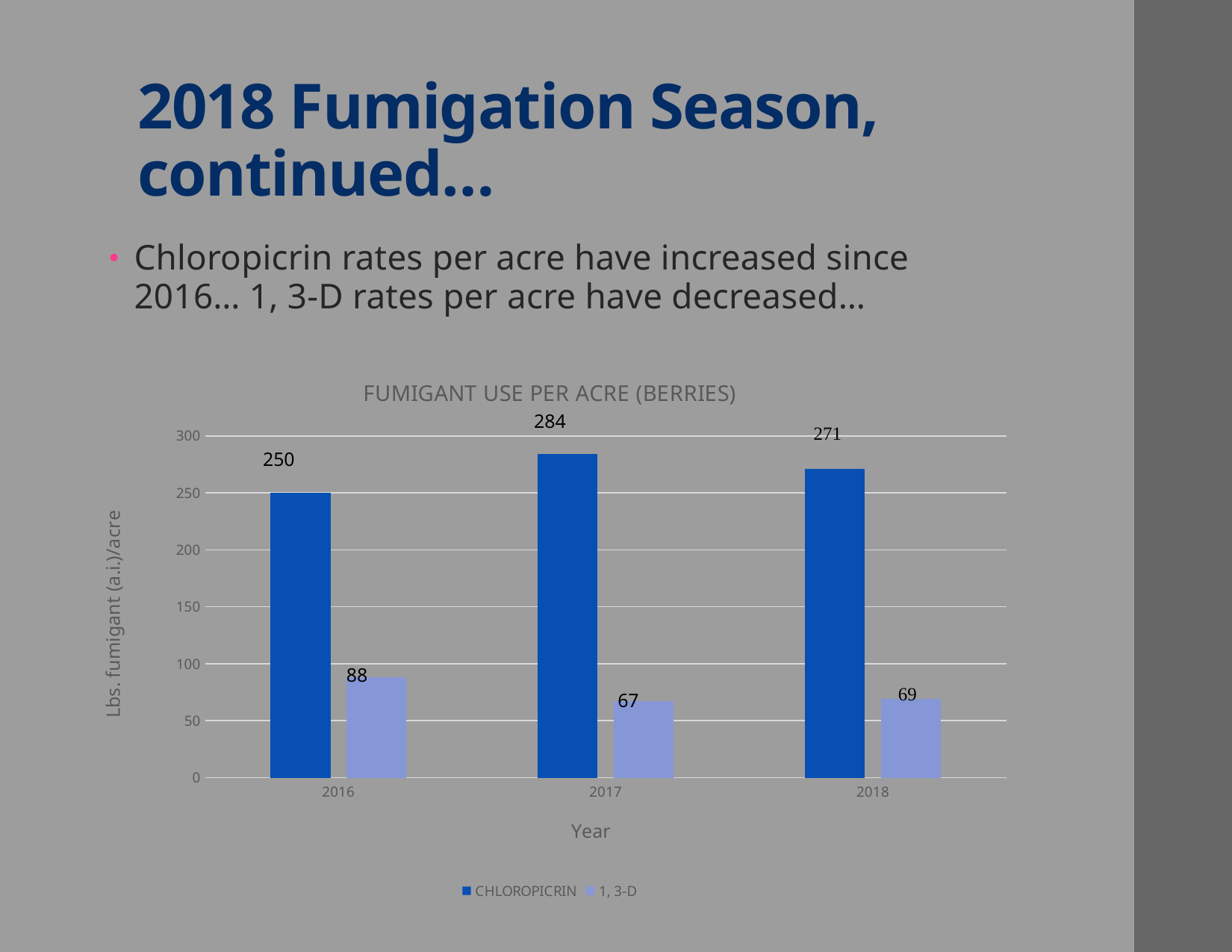
How many series does the legend list? 2 What is the 1, 3-D value for 2016? 88 In which year is the 1, 3-D value lowest? 2017 What is the difference between the 1, 3-D values for 2016 and 2018? 19 What is the difference between the Chloropicrin values for 2017 and 2016? 34 In which year is the Chloropicrin value highest? 2017 What kind of chart is shown on the slide? Bar chart What is the Chloropicrin value for 2017? 284 What is the Chloropicrin value for 2018? 271 What is the title of the chart? FUMIGANT USE PER ACRE (BERRIES) Which is larger, the Chloropicrin value for 2018 or for 2016? 2018 How many years are shown on the x axis? 3